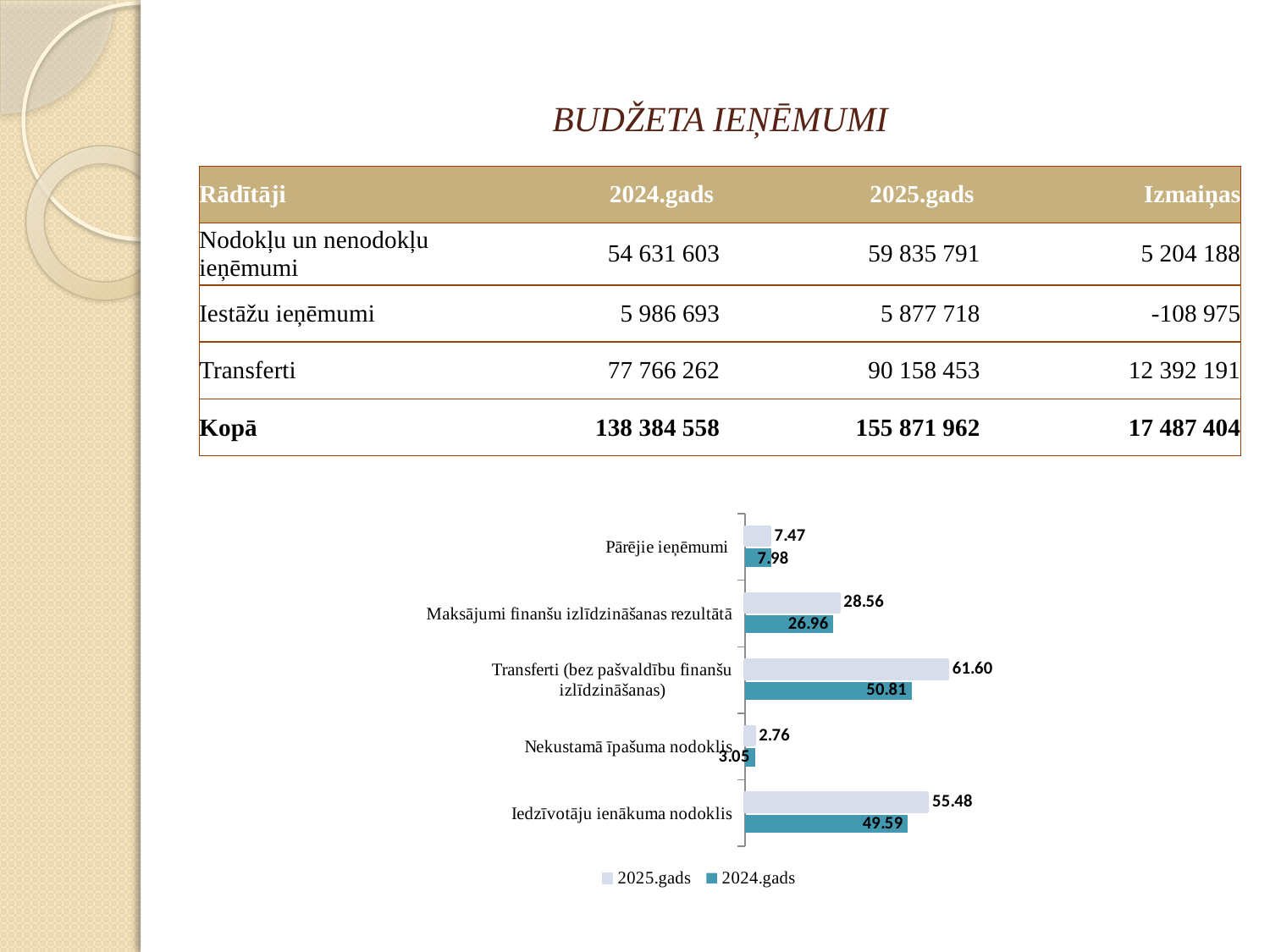
What is the difference between the 2025.gads and 2024.gads values for Iedzīvotāju ienākuma nodoklis in the chart? 5.89 What kind of chart is shown on the slide? bar chart Which category has the highest 2025.gads value in the chart? Transferti (bez pašvaldību finanšu izlīdzināšanas) How many categories are plotted in the chart? 5 For Pārējie ieņēmumi, which is larger in the chart: the 2025.gads value or the 2024.gads value? 2024.gads What is the 2024.gads value for Maksājumi finanšu izlīdzināšanas rezultātā in the chart? 26.96 What is the 2025.gads value for Transferti (bez pašvaldību finanšu izlīdzināšanas) in the chart? 61.60 Which category has the lowest 2024.gads value in the chart? Nekustamā īpašuma nodoklis How many series does the chart legend list? 2 What is the 2024.gads value for Iedzīvotāju ienākuma nodoklis in the chart? 49.59 Which series in the chart legend is shown in teal? 2024.gads What is the 2025.gads value for Nekustamā īpašuma nodoklis in the chart? 2.76